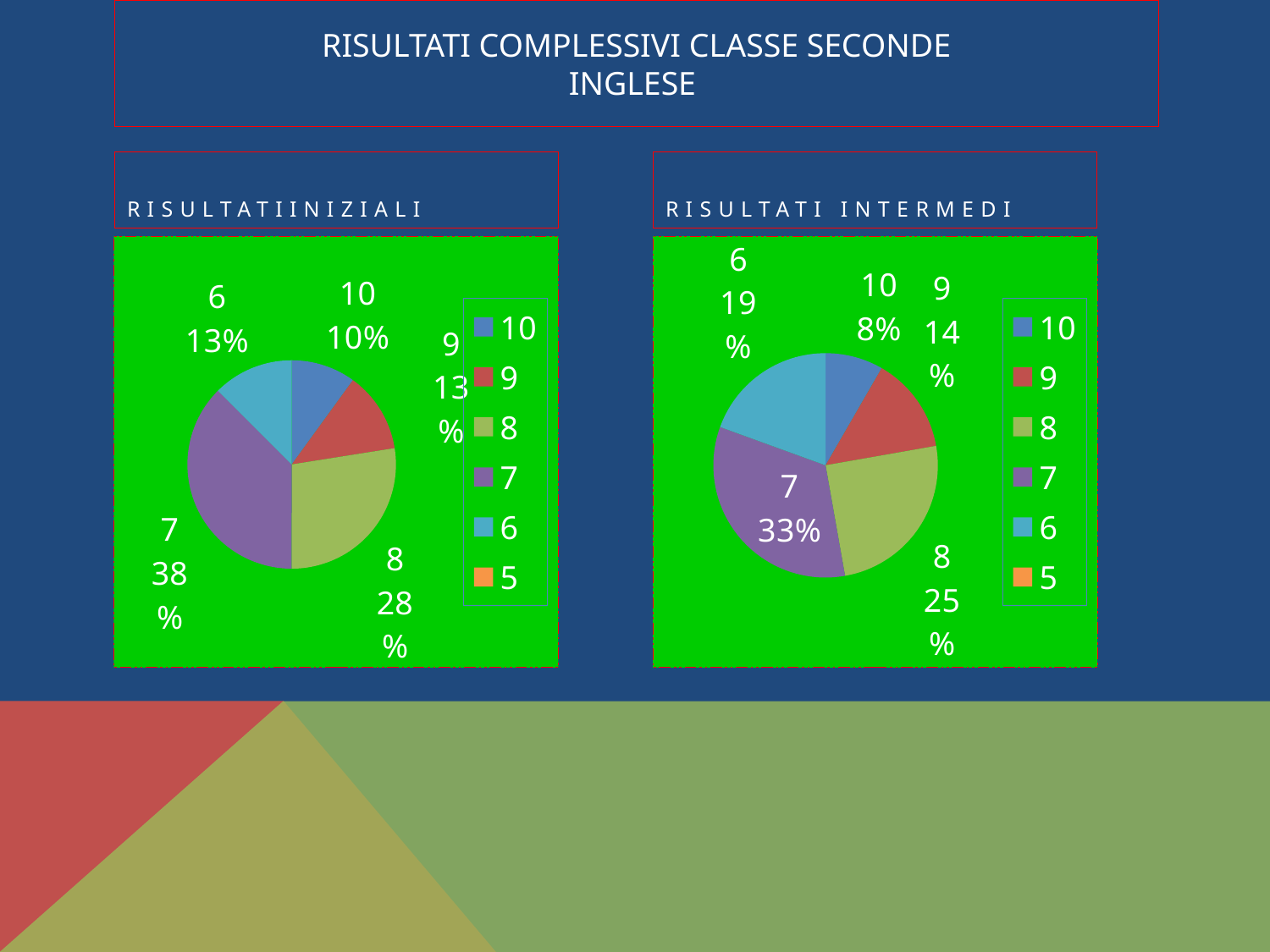
In the RISULTATI INTERMEDI chart, what is the difference in percentage points between the slices for 7 and 8? 8 In the RISULTATI INIZIALI chart, what percentage is shown for the slice labelled 8? 28% In the RISULTATI INTERMEDI chart, what share of the pie does the slice for 7 have? 33% In the RISULTATI INTERMEDI chart, which category has the smallest slice among those shown? 10 In the RISULTATI INTERMEDI chart, which slice is larger, 9 or 10? 9 In the RISULTATI INIZIALI chart, what share of the pie does the slice for 7 have? 38% What type of chart is used for RISULTATI INIZIALI? Pie chart In the RISULTATI INIZIALI chart, which category has the largest slice? 7 How many entries does the legend of the RISULTATI INTERMEDI chart list? 6 In the RISULTATI INIZIALI chart, which slice is larger, 8 or 6? 8 In the RISULTATI INTERMEDI chart, what percentage is shown for the slice labelled 6? 19% What is the title of the chart on the right side of the slide? RISULTATI INTERMEDI